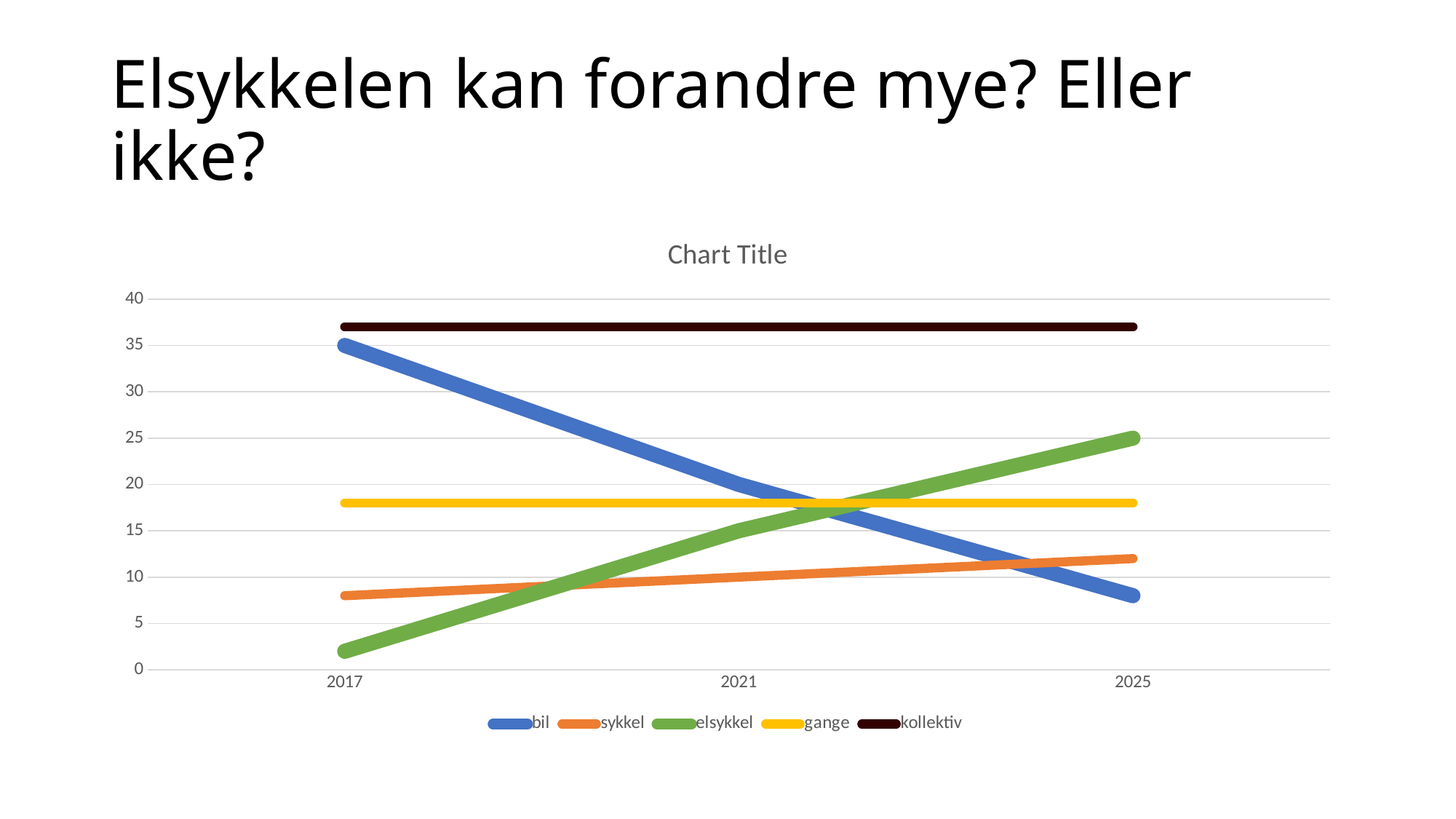
How many series does the legend list? 5 How many years are shown on the x axis? 3 In 2025, which is larger: elsykkel or bil? elsykkel Is the value for bil in 2025 greater or less than 10? less Which series has the lowest value in 2017? elsykkel Does the value for bil rise or fall from 2017 to 2025? fall What is the title shown above the chart? Chart Title Does the value for elsykkel rise or fall from 2017 to 2025? rise Is the value for elsykkel in 2017 greater or less than 5? less What kind of chart is shown on the slide? line chart Is the value for kollektiv in 2017 greater or less than 35? greater